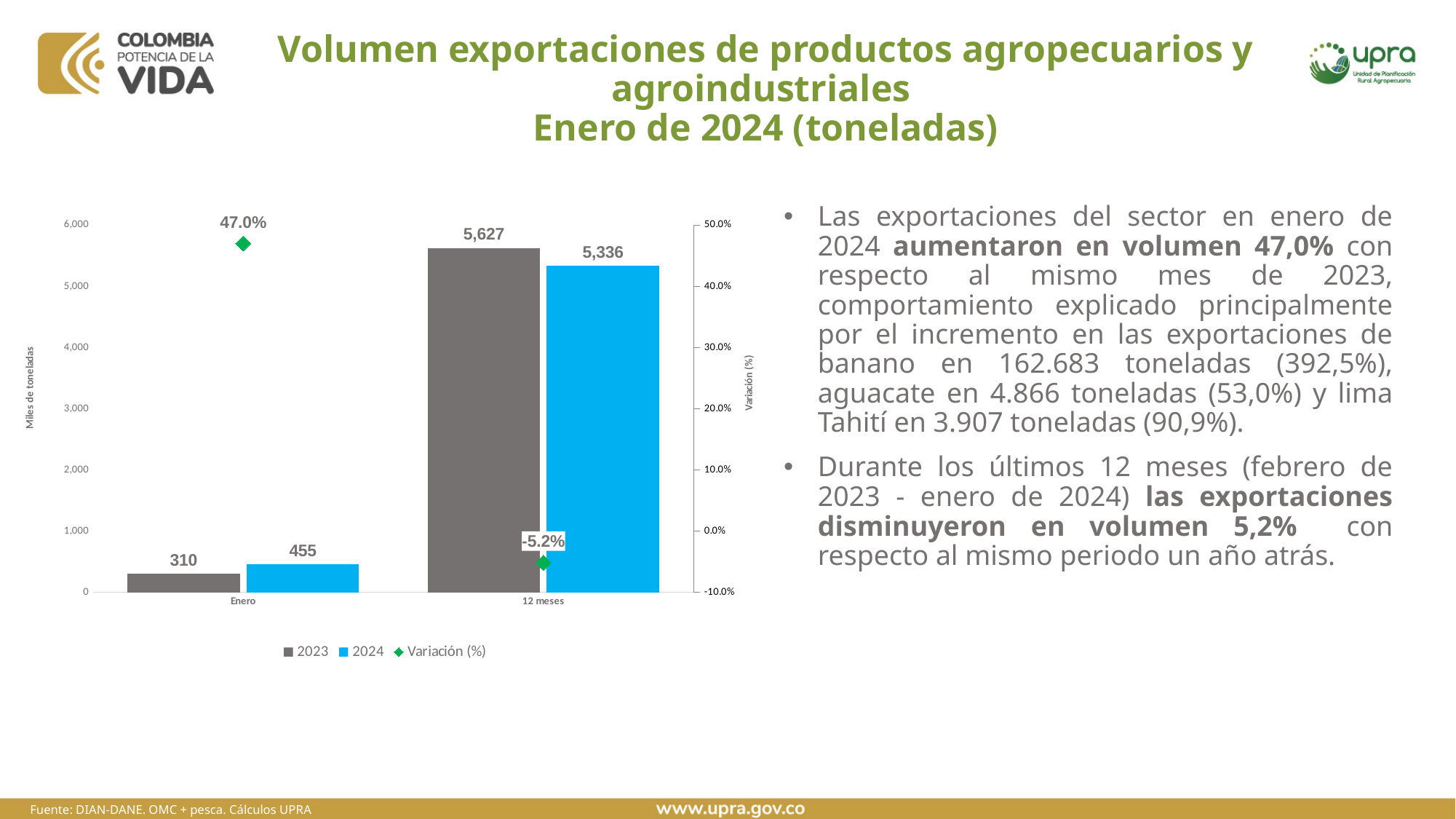
How many categories are shown on the x axis? 2 What is the label of the left vertical axis? Miles de toneladas What is the value for 2024 in the Enero category? 455 What is the value for 2023 in the Enero category? 310 What is the Variación (%) value for 12 meses? -5.2% What is the Variación (%) value for Enero? 47.0% What is the difference between the 2023 and 2024 values in the 12 meses category? 291 What is the difference between the 2024 and 2023 values in the Enero category? 145 What is the value for 2023 in the 12 meses category? 5,627 How many series does the legend list? 3 Which is larger in the 12 meses category, the 2023 value or the 2024 value? 2023 What is the value for 2024 in the 12 meses category? 5,336